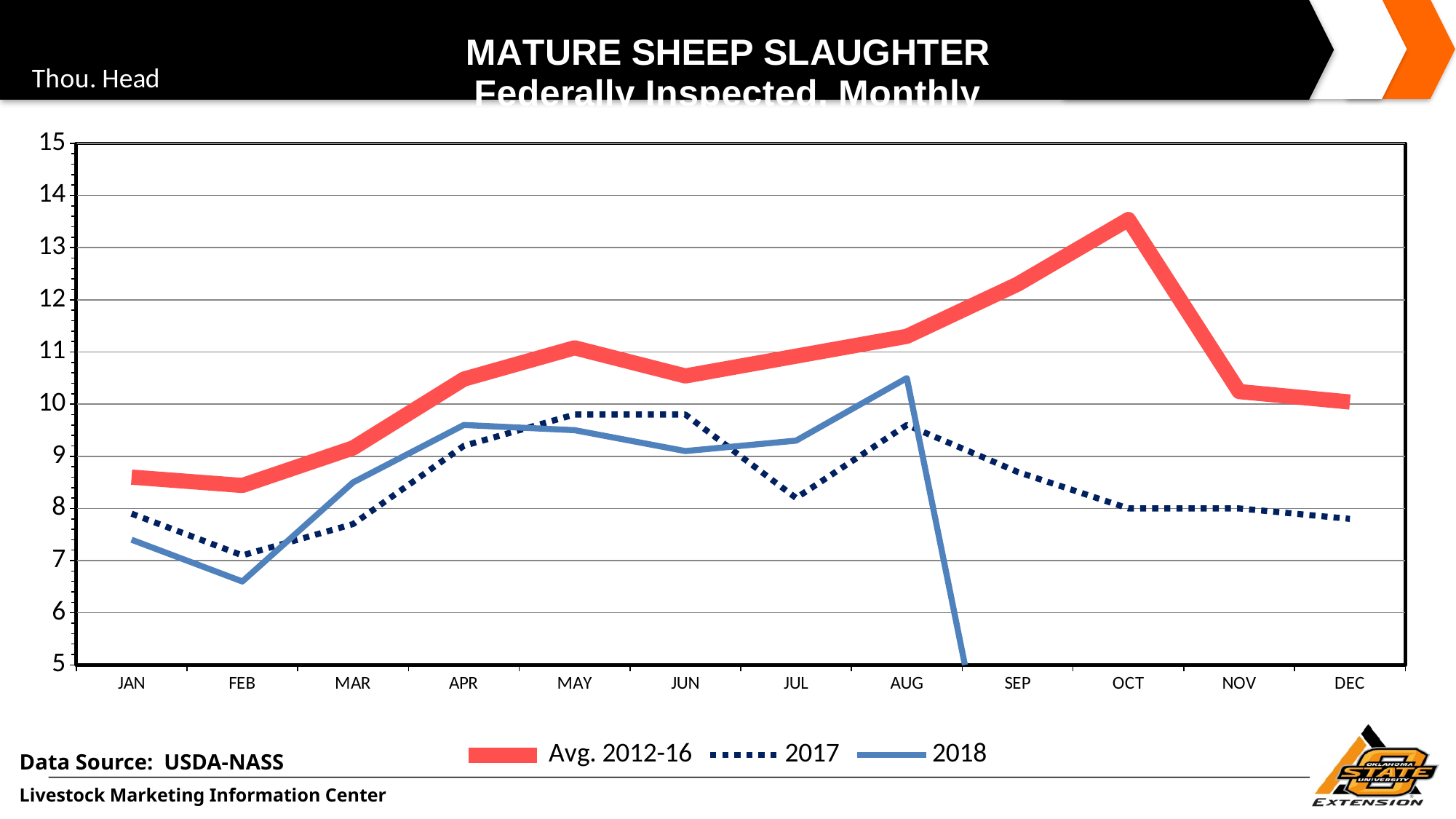
Is the Avg. 2012-16 value for OCT greater or less than 13? greater In which month does the 2017 series reach its lowest value? FEB What kind of chart is shown on the slide? Line chart Which series has the higher value in OCT, Avg. 2012-16 or 2017? Avg. 2012-16 In which month does the Avg. 2012-16 series reach its highest value? OCT What unit is shown in the top-left corner of the chart? Thou. Head How many series does the legend list? 3 In which month does the 2018 series reach its highest value? AUG Does the Avg. 2012-16 series rise or fall from OCT to DEC? Fall Is the 2018 value for AUG greater or less than 10? greater Is the 2017 value for FEB greater or less than 8? less How many months are plotted along the x axis? 12